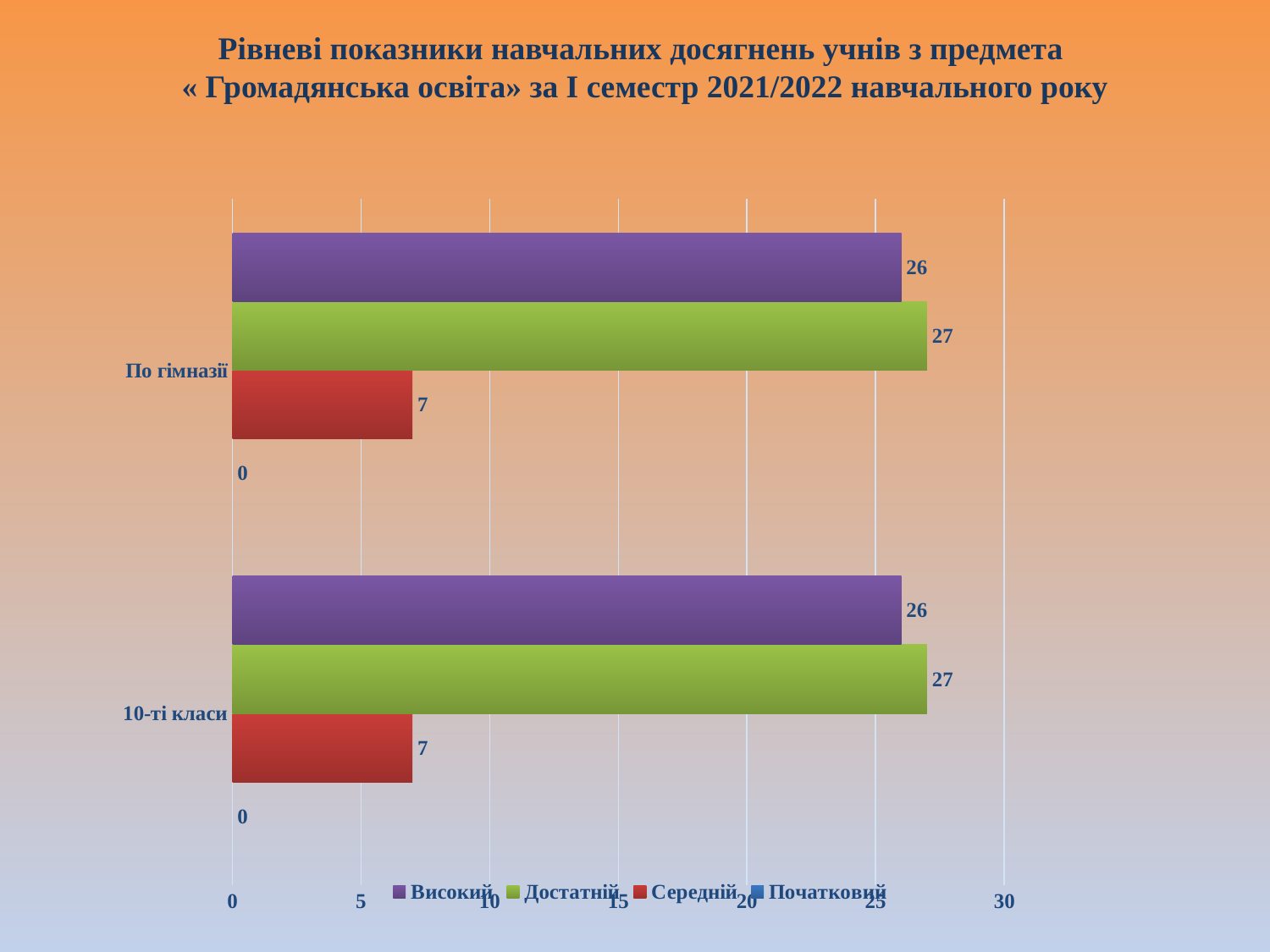
What is the value for Початковий in the По гімназії category? 0 Which series has the highest value in the По гімназії category? Достатній What is the value for Високий in the По гімназії category? 26 What is the value for Достатній in the 10-ті класи category? 27 How many series does the legend list? 4 How many categories are shown on the vertical axis? 2 Which series has the lowest value in the 10-ті класи category? Початковий What kind of chart is shown on the slide? bar chart In the По гімназії category, which is larger: Високий or Середній? Високий What is the value for Середній in the 10-ті класи category? 7 What is the difference between the Достатній and Середній values in the 10-ті класи category? 20 Which series is shown in green in the legend? Достатній